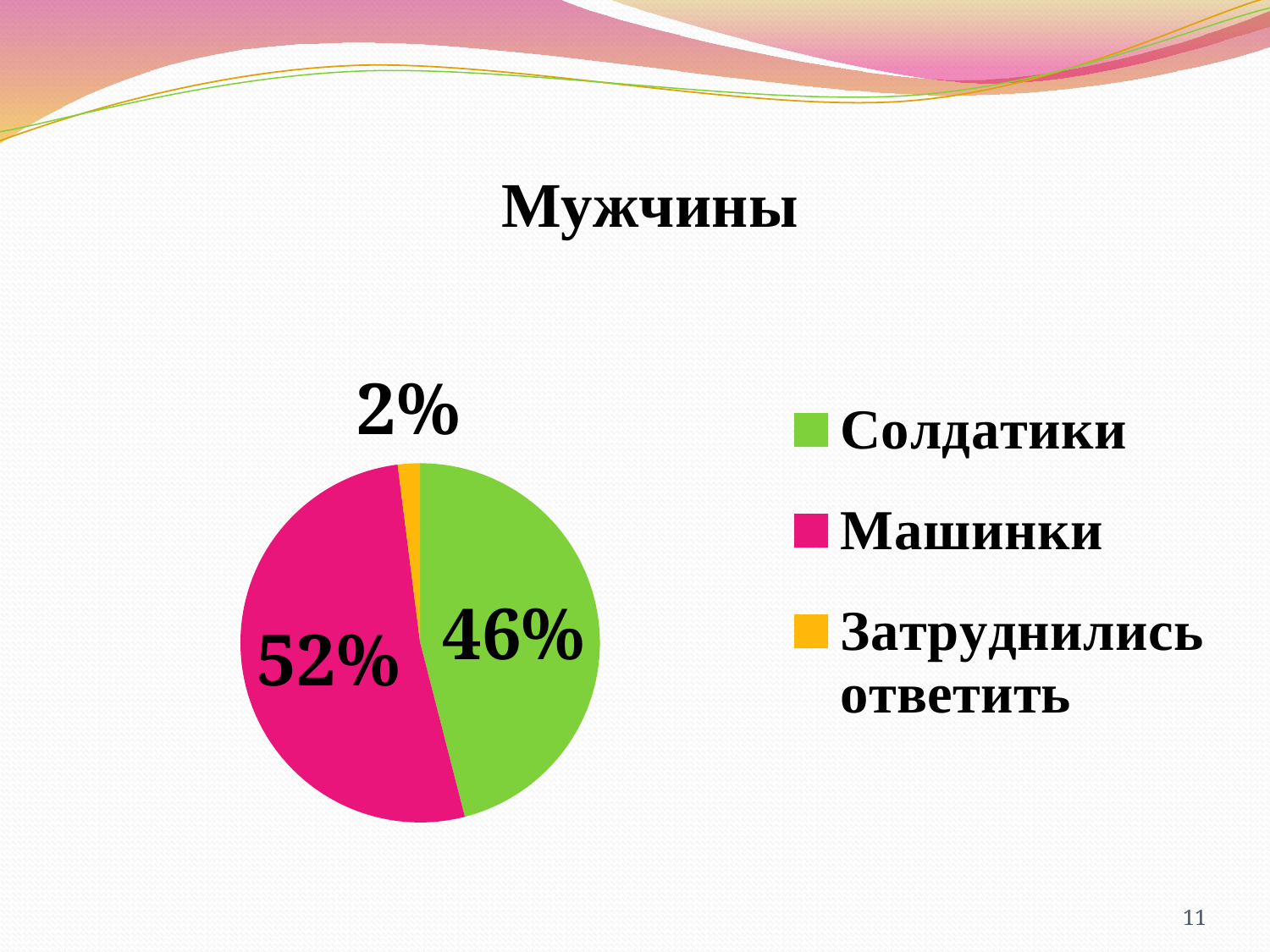
How many slices does the pie chart have? 3 What is the difference in percentage points between Машинки and Солдатики? 6 What percentage of the pie is labelled Затруднились ответить? 2% Which category has the smallest share of the pie? Затруднились ответить Which category has the largest share of the pie? Машинки What percentage of the pie is labelled Машинки? 52% Which is larger, the share for Солдатики or the share for Машинки? Машинки What colour is the slice for Затруднились ответить? yellow How many entries does the legend list? 3 What type of chart is shown on the slide? pie chart What percentage of the pie is labelled Солдатики? 46% What is the title of the chart? Мужчины